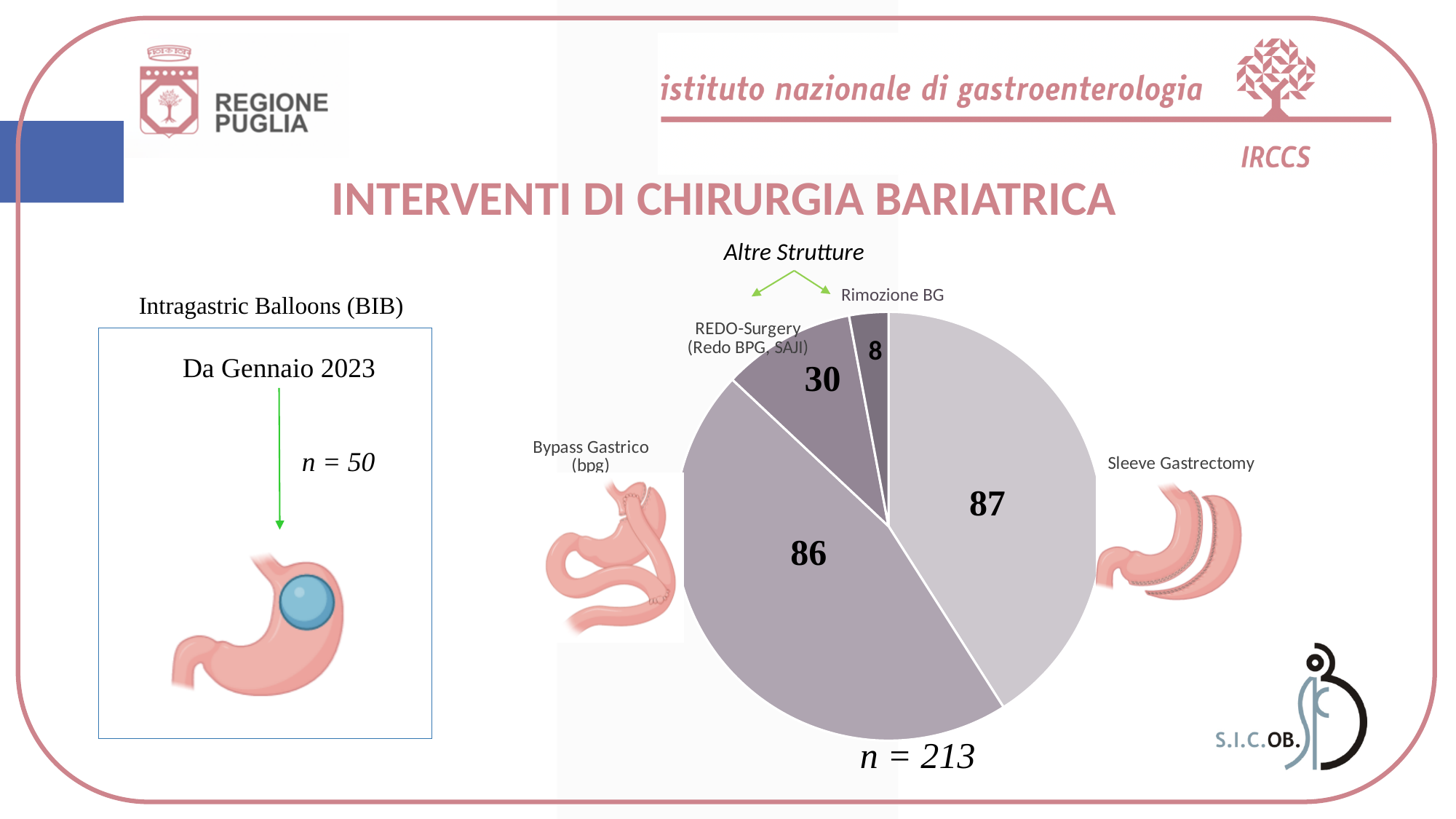
What is the value for Rimozione BG in the pie chart? 8 Which category has the smallest slice in the pie chart? Rimozione BG What is the difference between the REDO-Surgery value and the Rimozione BG value? 22 What is the value for REDO-Surgery (Redo BPG, SAJI) in the pie chart? 30 Which is larger, the value for Bypass Gastrico (bpg) or the value for REDO-Surgery? Bypass Gastrico (bpg) What is the difference between the Sleeve Gastrectomy value and the REDO-Surgery value? 57 How many slices does the pie chart have? 4 What type of chart is shown on the slide? pie chart What total n is printed below the pie chart? n = 213 What is the value for Sleeve Gastrectomy in the pie chart? 87 What is the value for Bypass Gastrico (bpg) in the pie chart? 86